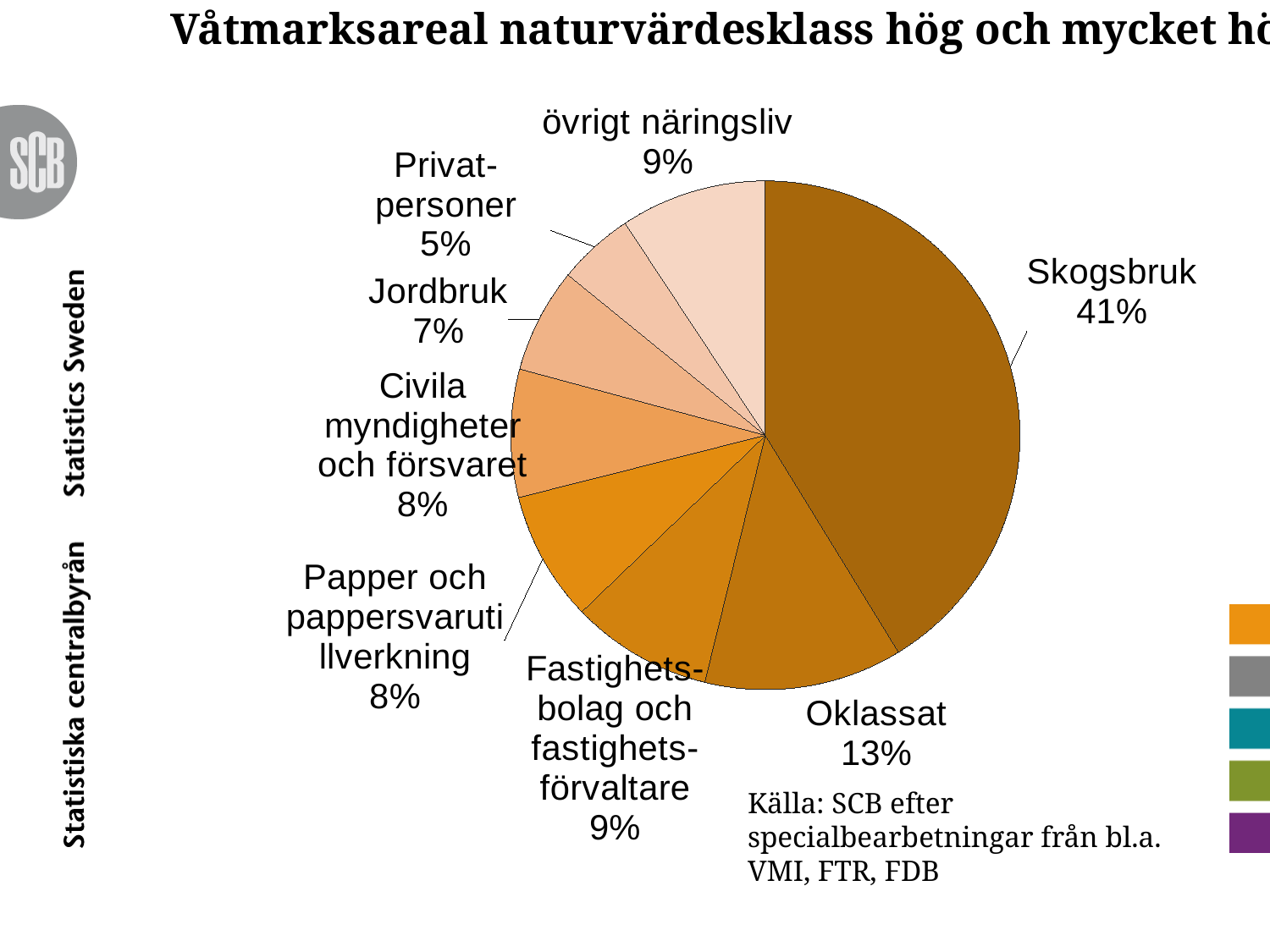
What is the difference in percentage points between Skogsbruk and Oklassat? 28 How many slices does the pie chart have? 8 What is the value shown for Jordbruk? 7% Which category has the largest slice of the pie? Skogsbruk What kind of chart is shown on the slide? pie chart What share of the pie does Skogsbruk have? 41% What is the value shown for Privatpersoner? 5% Which is larger, the slice for Jordbruk or the slice for Oklassat? Oklassat What is the value shown for Oklassat? 13% Which category has the smallest slice of the pie? Privatpersoner What is the value shown for övrigt näringsliv? 9% What is the value shown for Civila myndigheter och försvaret? 8%